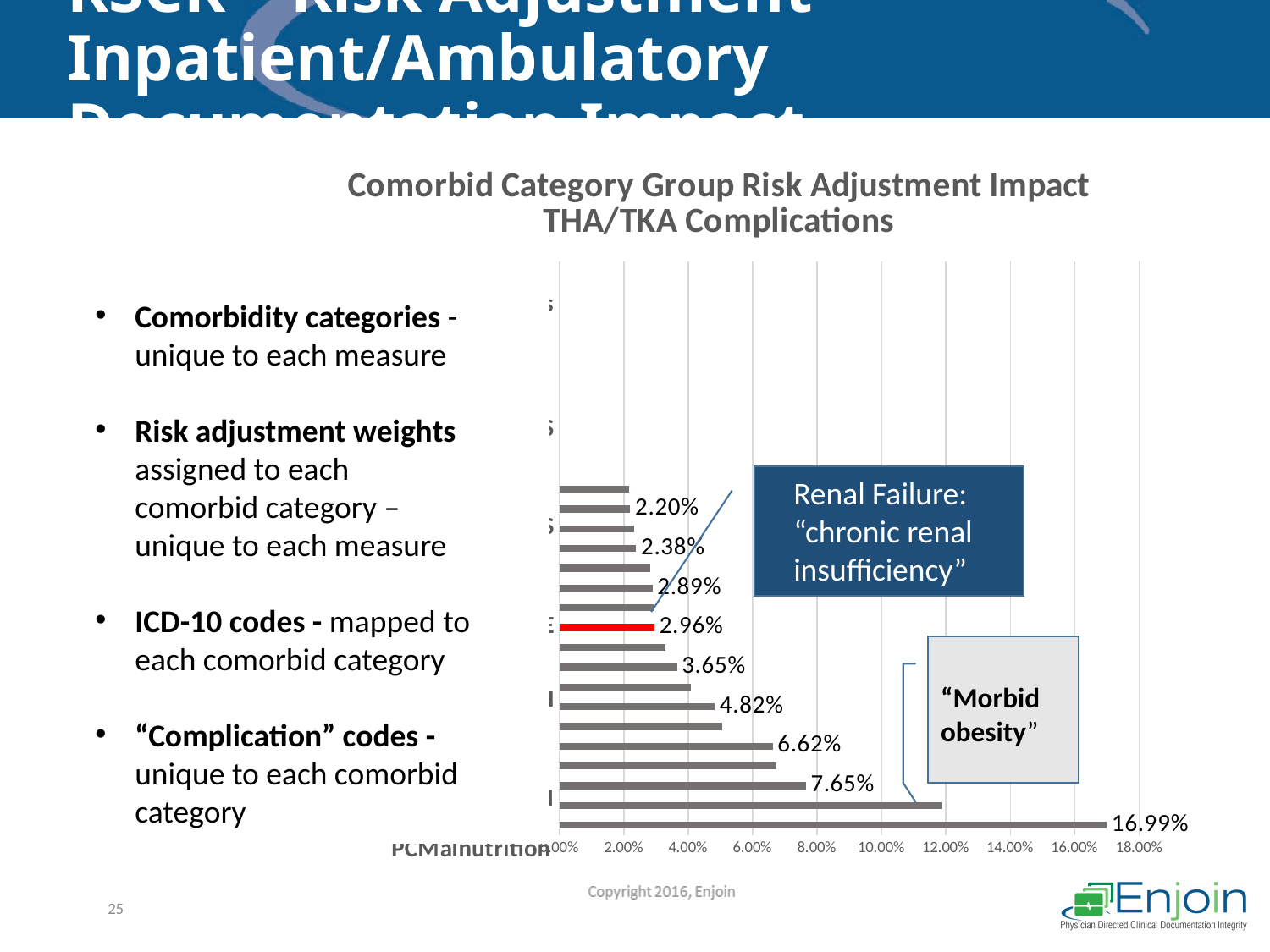
What is the smallest value labelled on the chart? 2.20% Which is larger, the bar labelled 3.65% or the bar labelled 2.96%? 3.65% What is the largest value labelled on the chart? 16.99% What is the difference between the largest labelled value (16.99%) and the next largest labelled value (7.65%)? 9.34% Is the value of the bar labelled 7.65% greater or less than 8.00%? less What value is labelled on the bar highlighted in red? 2.96% What is the difference between the labelled values 6.62% and 4.82%? 1.80% How many bars on the chart have a printed data label? 9 What is the difference between the labelled values 2.89% and 2.38%? 0.51% What kind of chart is shown on the slide? bar chart Is the value of the longest bar greater or less than 16.00%? greater What is the title of the chart? Comorbid Category Group Risk Adjustment Impact THA/TKA Complications